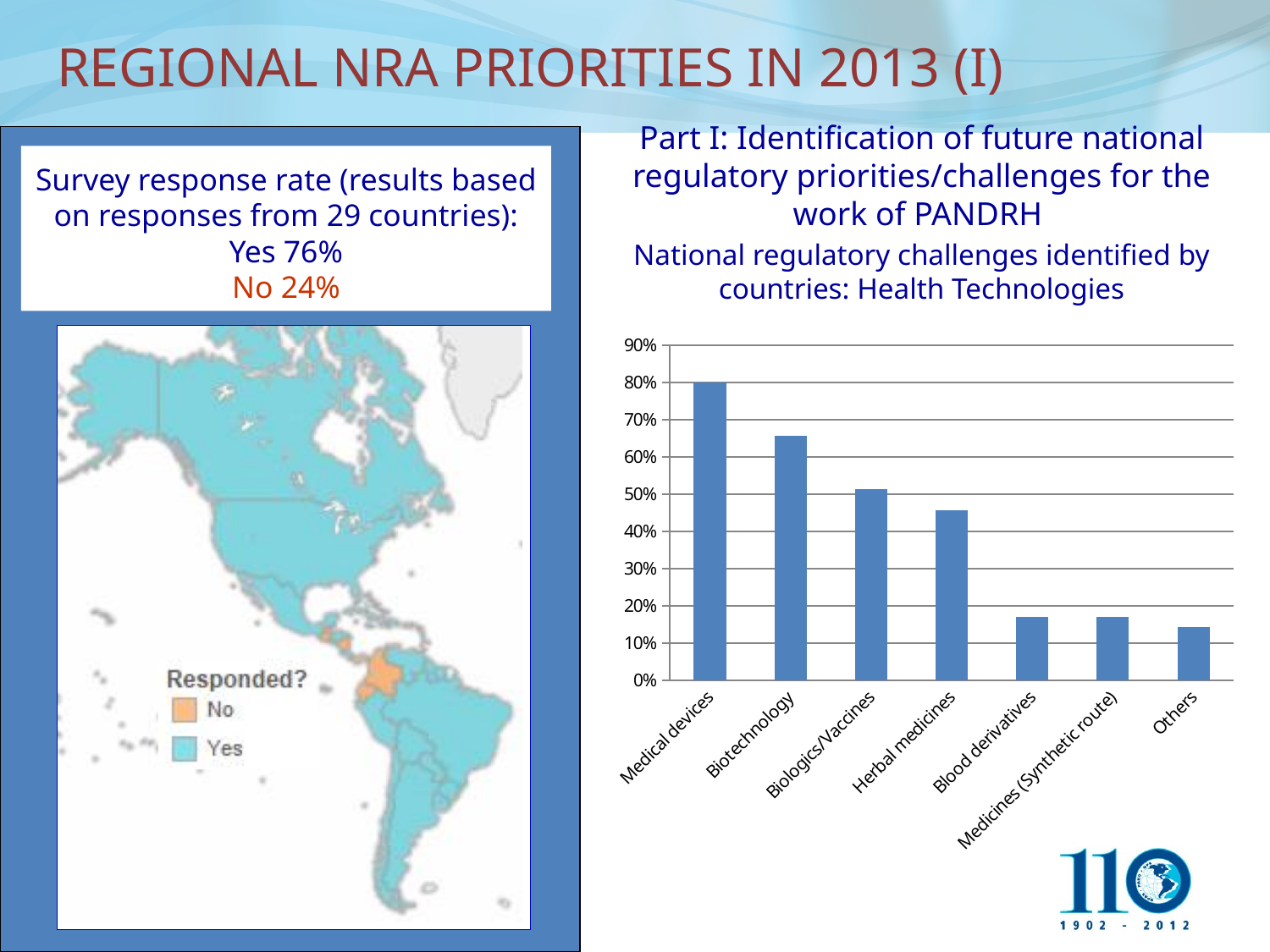
How many categories are shown on the x axis of the Health Technologies bar chart? 7 In the Health Technologies bar chart, what is the value for Medical devices? 80% In the Health Technologies bar chart, is the value for Herbal medicines greater or less than 50%? less In the Health Technologies bar chart, is the value for Biotechnology greater or less than 60%? greater Which category has the lowest value in the Health Technologies bar chart? Others Do the values in the Health Technologies bar chart rise or fall from left to right along the x axis? fall What kind of chart is used to show the national regulatory challenges identified by countries for Health Technologies? bar chart What is the highest value shown on the y axis of the Health Technologies bar chart? 90% Which category has the highest value in the Health Technologies bar chart? Medical devices In the Health Technologies bar chart, which is larger: Biotechnology or Herbal medicines? Biotechnology In the Health Technologies bar chart, is the value for Others greater or less than 10%? greater